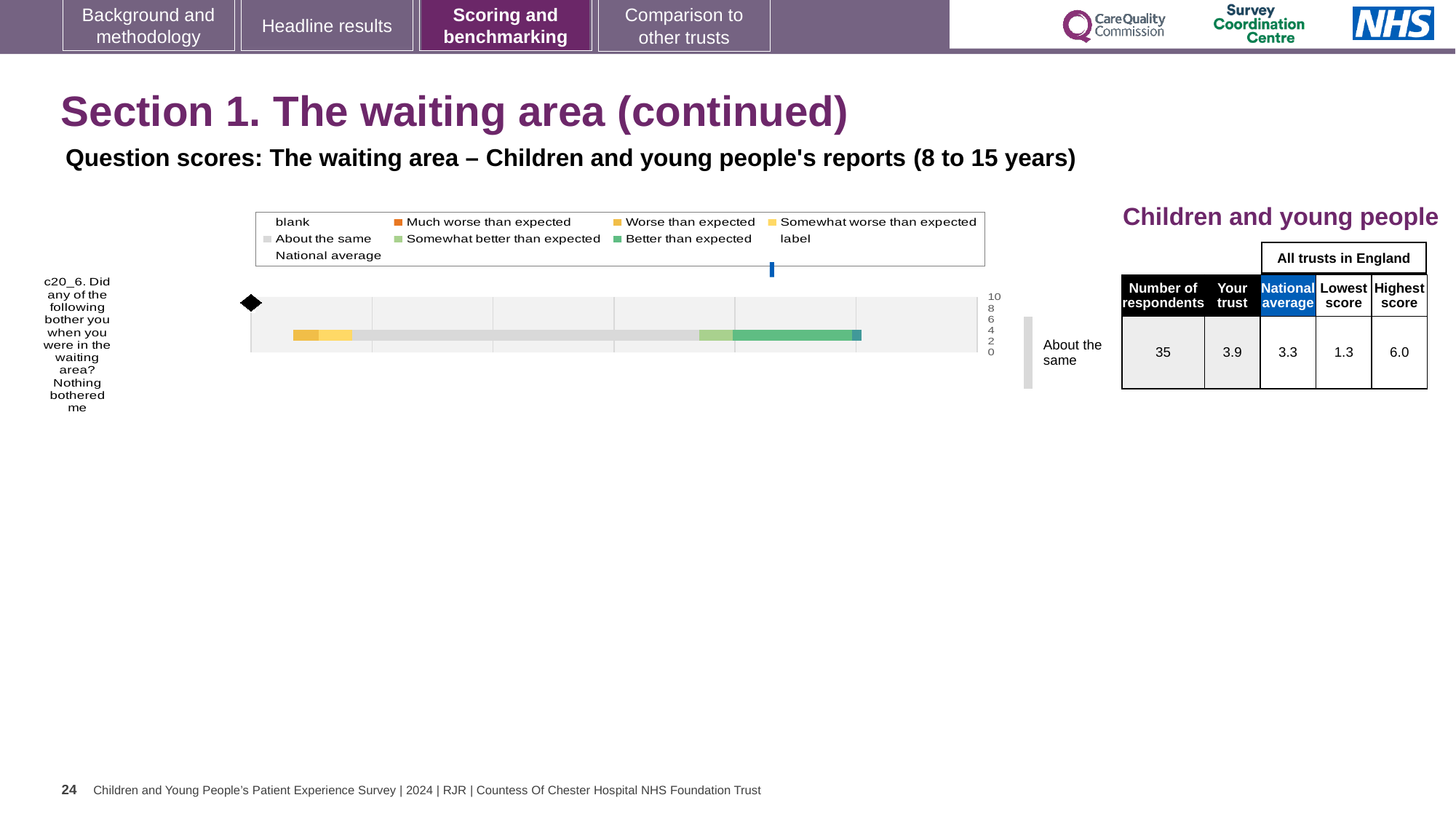
In the table beside the chart, what is the number of respondents for question c20_6? 35 In the table beside the chart, what is the national average score for question c20_6? 3.3 Which question is plotted on the chart? c20_6. Did any of the following bother you when you were in the waiting area? Nothing bothered me What kind of chart is shown on the slide? bar chart What is the difference between the 'Your trust' score and the national average for question c20_6? 0.6 What benchmark category label is shown next to the chart for question c20_6? About the same Is the 'Your trust' score (3.9) larger or smaller than the national average (3.3) for question c20_6? larger In the table beside the chart, what is the 'Your trust' score for question c20_6? 3.9 In the table beside the chart, what is the highest score among all trusts in England for question c20_6? 6.0 In the table beside the chart, what is the lowest score among all trusts in England for question c20_6? 1.3 What is the highest tick value shown on the chart's axis? 10 How many question categories are plotted on the chart? 1